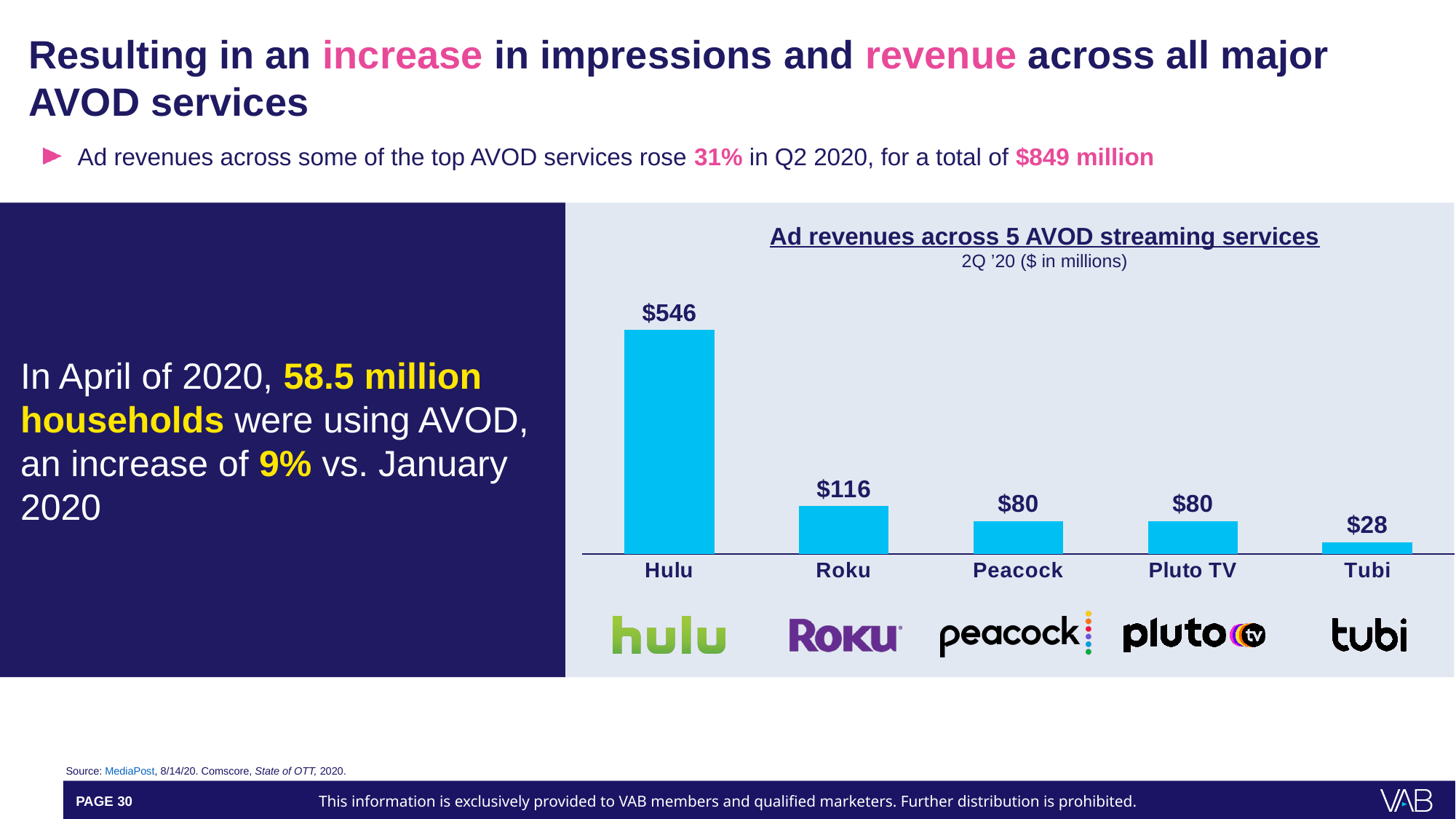
How many services are shown in the chart? 5 What is the difference between Hulu's and Roku's ad revenue values? $430 What is the title of the chart? Ad revenues across 5 AVOD streaming services What kind of chart is used to show ad revenues across the AVOD services? Bar chart What unit is stated in the chart subtitle? $ in millions Which service has the highest ad revenue in the chart? Hulu What is the ad revenue value shown for Tubi? $28 What is the difference between Roku's and Tubi's ad revenue values? $88 What is the ad revenue value shown for Hulu? $546 Which service has the lowest ad revenue in the chart? Tubi What is the ad revenue value shown for Roku? $116 Which has a larger ad revenue value, Roku or Peacock? Roku